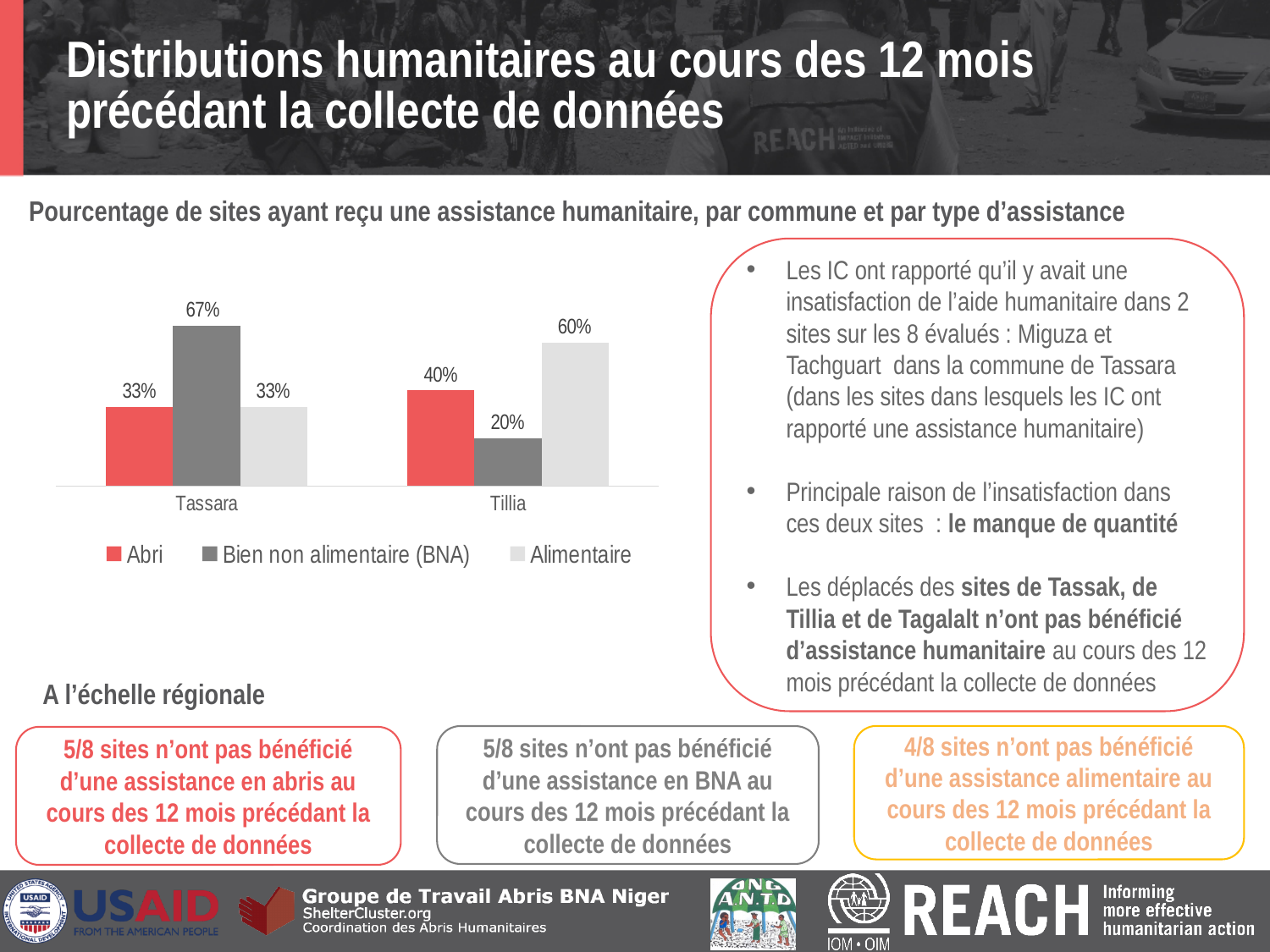
Which type of assistance has the lowest value in Tillia? Bien non alimentaire (BNA) Which colour represents the Abri series in the chart? Red What kind of chart is used to show the percentage of sites that received humanitarian assistance? Bar chart Which type of assistance has the highest value in Tassara? Bien non alimentaire (BNA) What percentage of sites in Tassara received Bien non alimentaire (BNA) assistance? 67% How many communes are shown on the x axis of the chart? 2 How many series does the chart legend list? 3 What is the value for Bien non alimentaire (BNA) in Tillia? 20% What is the value for Abri assistance in Tillia? 40% What is the value for Alimentaire assistance in Tillia? 60% What is the difference between the Bien non alimentaire (BNA) values for Tassara and Tillia? 47 percentage points Which commune has the larger value for Alimentaire assistance, Tassara or Tillia? Tillia